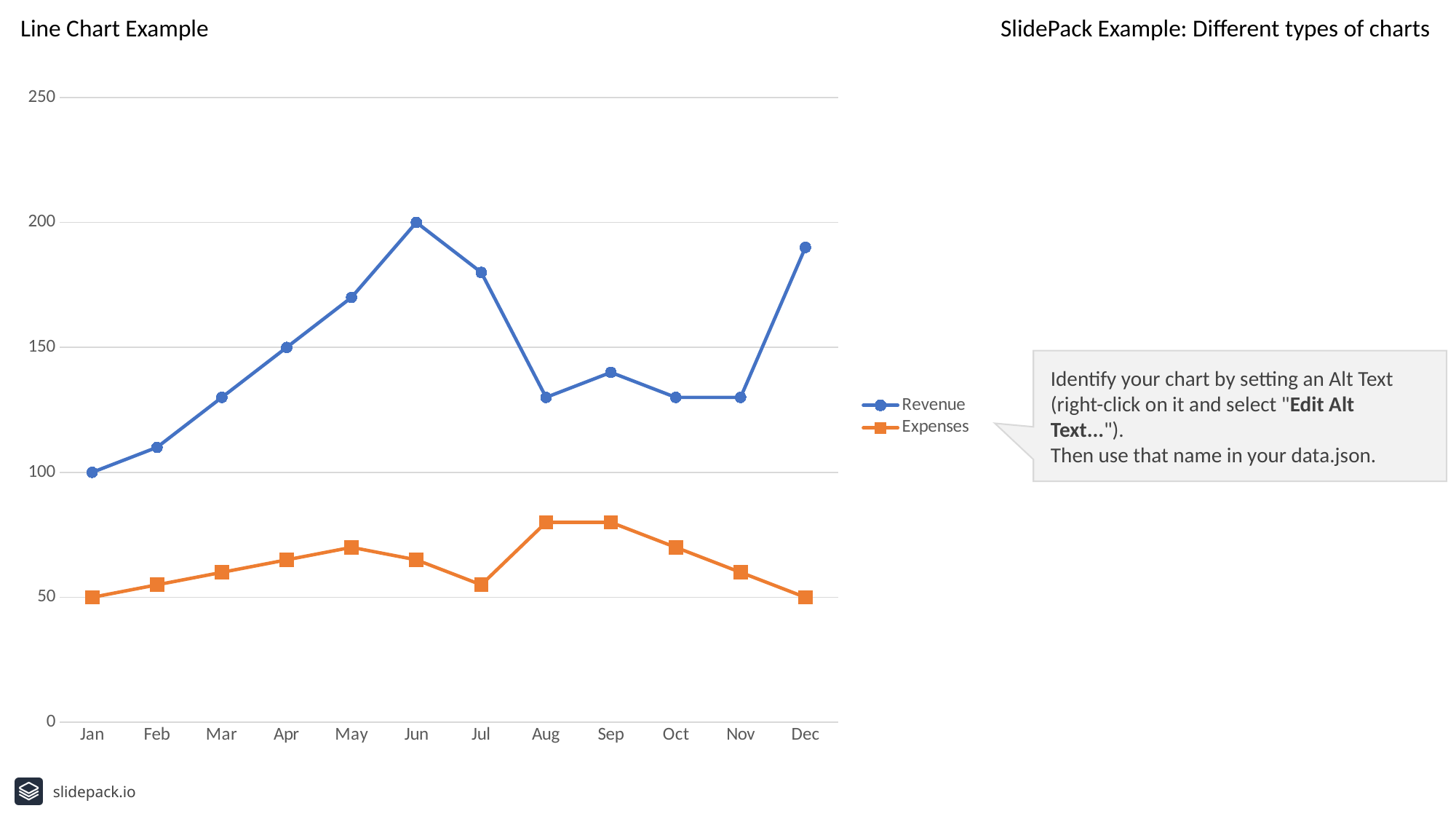
In which month is Revenue lowest? Jan Does Revenue rise or fall from Jan to Jun? Rise In which month is Revenue highest? Jun What is the difference between Revenue in Jun and Revenue in Jan? 100 What is the Revenue value for Jan? 100 What is the Revenue value for Jun? 200 Which series is drawn in orange? Expenses Is the Revenue value for Dec greater or less than 150? greater How many months are plotted along the x axis? 12 What type of chart is shown on the slide? Line chart How many series does the legend list? 2 What is the Expenses value for Jan? 50